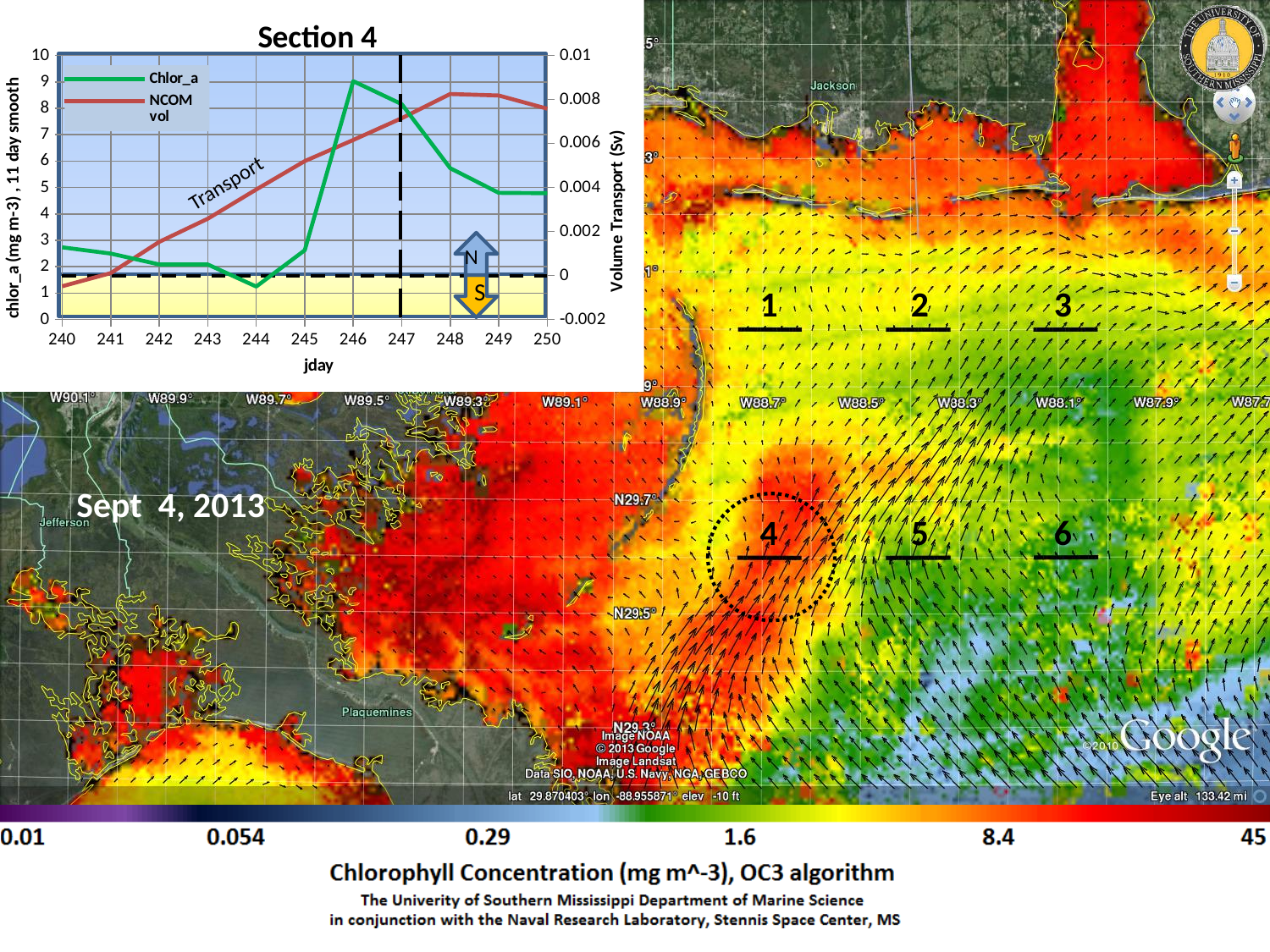
In the 'Section 4' chart, is the Chlor_a value at jday 244 greater or less than 2? less How many jday points are plotted along the x axis of the 'Section 4' chart? 11 What is the label of the x axis in the 'Section 4' chart? jday What are the two series named in the legend of the 'Section 4' chart? Chlor_a and NCOM vol In the 'Section 4' chart, at which jday does the Chlor_a series reach its highest value? 246 In the 'Section 4' chart, at which jday is the NCOM vol series lowest? 240 In the 'Section 4' chart, is the Chlor_a value at jday 246 greater or less than 8? greater What kind of chart is shown in the 'Section 4' chart? line chart How many series does the legend of the 'Section 4' chart list? 2 In the 'Section 4' chart, does the NCOM vol series rise or fall from jday 240 to jday 248? rise In the 'Section 4' chart, is the NCOM vol value at jday 240 greater or less than 0? less In the 'Section 4' chart, at which jday does the Chlor_a series reach its lowest value? 244